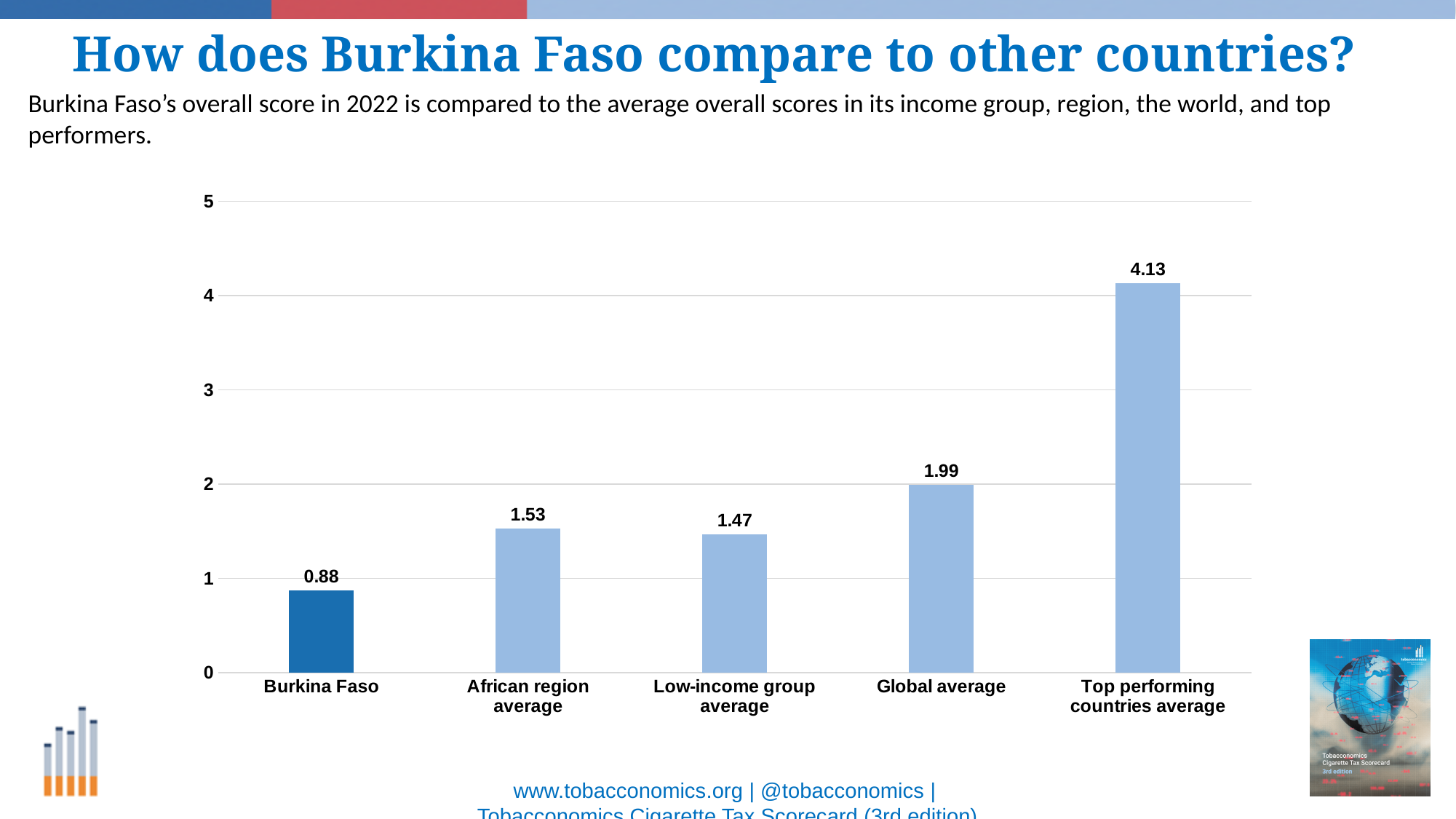
Which category has the lowest value? Burkina Faso What is the value for the Global average? 1.99 What is the difference between the Global average and Burkina Faso? 1.11 What is the value for the Low-income group average? 1.47 What is the value for the Top performing countries average? 4.13 What is the difference between the Top performing countries average and Burkina Faso? 3.25 What is the value for the African region average? 1.53 Which category has the highest value? Top performing countries average What is the value for Burkina Faso? 0.88 What kind of chart is shown on the slide? Bar chart How many categories are shown on the chart? 5 Which is larger, the African region average or the Low-income group average? African region average